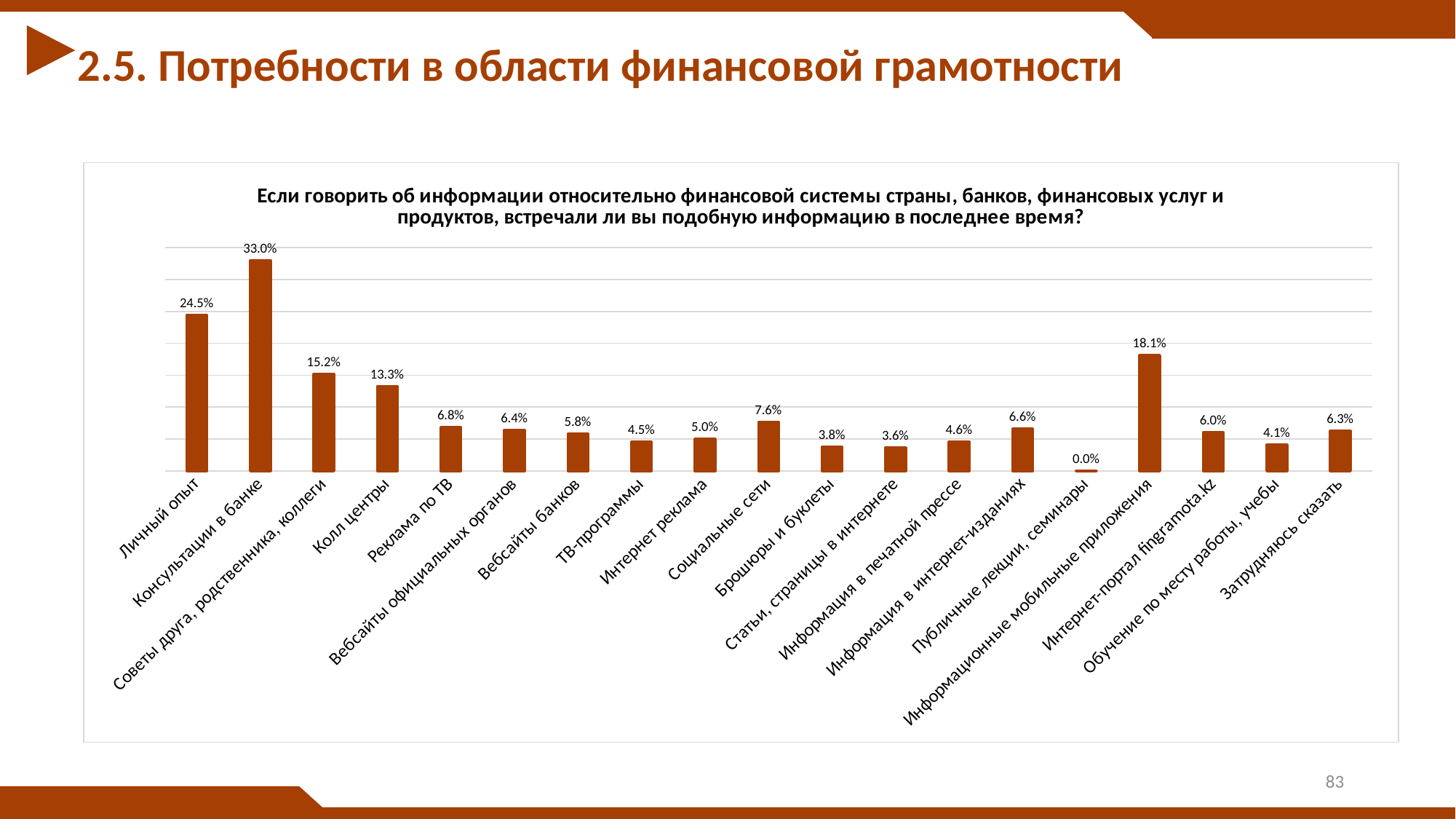
Which category has the highest value? Консультации в банке Which is larger: Реклама по ТВ or Вебсайты банков? Реклама по ТВ How many categories are shown on the x axis? 19 What value is shown for Затрудняюсь сказать? 6.3% What kind of chart is this? Bar chart What value is shown for Социальные сети? 7.6% What value is shown for Консультации в банке? 33.0% What value is shown for Интернет-портал fingramota.kz? 6.0% What is the difference between Советы друга, родственника, коллеги and Колл центры? 1.9% What is the difference between Консультации в банке and Личный опыт? 8.5% What value is shown for Информационные мобильные приложения? 18.1% Which category has the lowest value? Публичные лекции, семинары